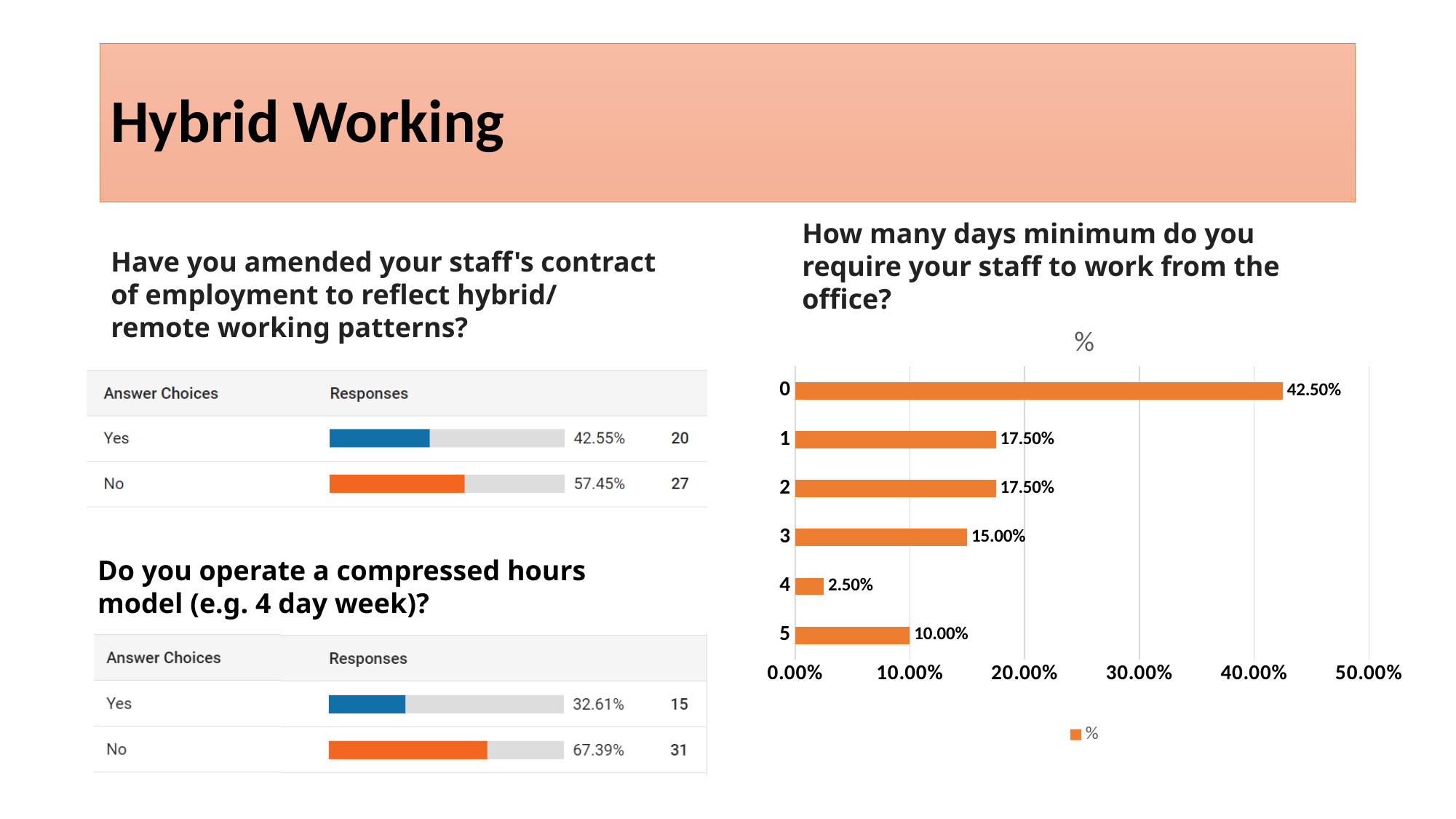
In the bar chart 'How many days minimum do you require your staff to work from the office?', what is the value for 0 days? 42.50% In the bar chart 'How many days minimum do you require your staff to work from the office?', is the value for 0 days greater or less than 40.00%? greater In the bar chart 'How many days minimum do you require your staff to work from the office?', which category has the lowest value? 4 In the bar chart 'How many days minimum do you require your staff to work from the office?', what is the value for 5 days? 10.00% In the bar chart 'How many days minimum do you require your staff to work from the office?', which is larger, the value for 3 days or the value for 5 days? 3 days In the table 'Have you amended your staff's contract of employment to reflect hybrid/remote working patterns?', what percentage of responses were 'No'? 57.45% What kind of chart is used for 'How many days minimum do you require your staff to work from the office?'? bar chart In the bar chart 'How many days minimum do you require your staff to work from the office?', what is the difference between the values for 0 days and 1 day? 25.00% How many categories are shown in the bar chart 'How many days minimum do you require your staff to work from the office?'? 6 In the bar chart 'How many days minimum do you require your staff to work from the office?', what is the value for 3 days? 15.00% How many series does the legend of the bar chart 'How many days minimum do you require your staff to work from the office?' list? 1 In the bar chart 'How many days minimum do you require your staff to work from the office?', which category has the highest value? 0